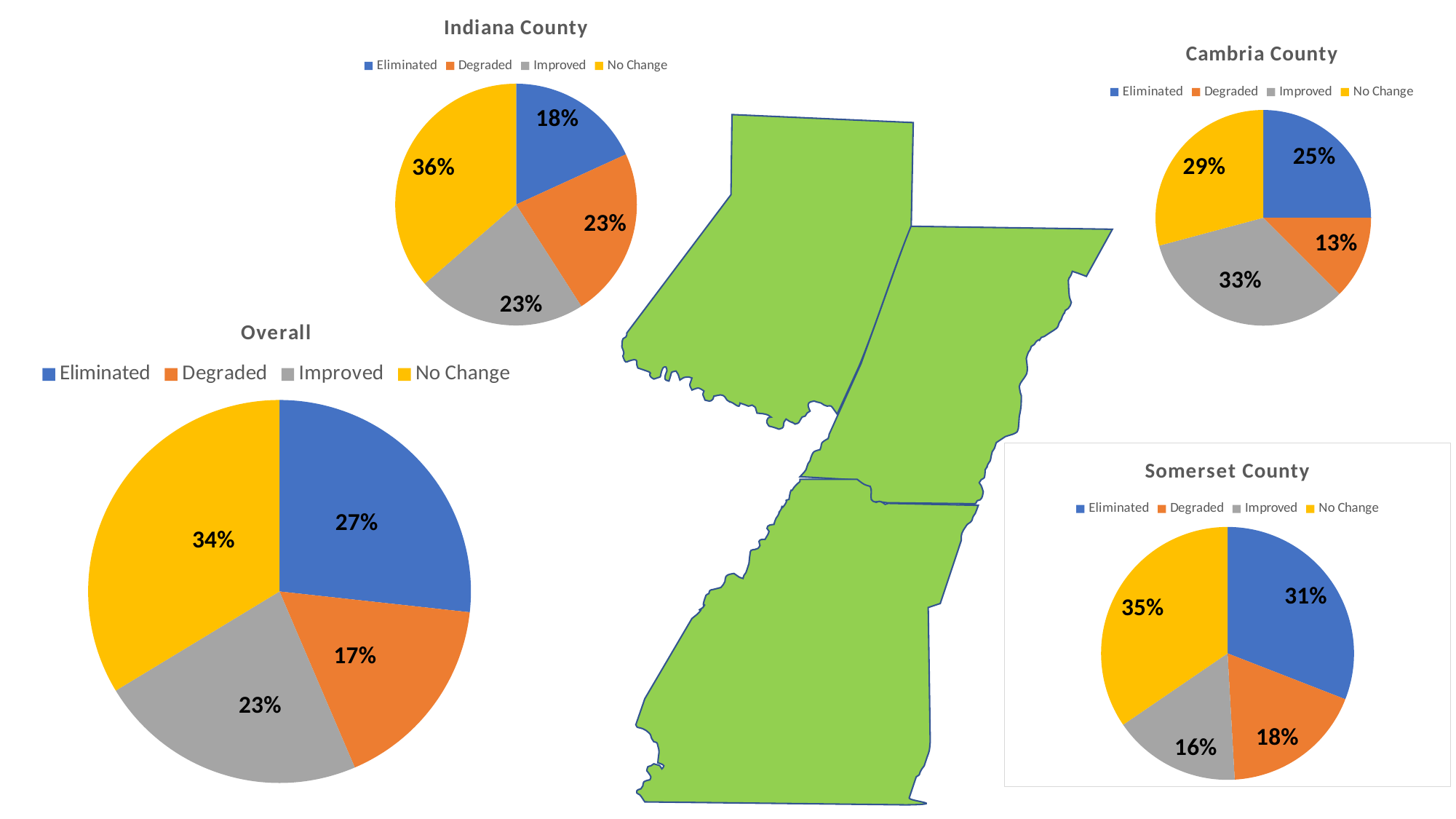
In the Cambria County pie chart, which category has the largest share? Improved What kind of chart is the Cambria County chart? Pie chart How many slices does the Somerset County pie chart have? 4 In the Cambria County pie chart, what percentage is shown for Degraded? 13% In the Indiana County pie chart, which is larger, the Eliminated slice or the Degraded slice? Degraded In the Overall pie chart, which colour represents No Change? Yellow In the Indiana County pie chart, what percentage is shown for No Change? 36% In the Somerset County pie chart, what percentage is shown for Improved? 16% How many entries does the legend of the Overall chart list? 4 In the Overall pie chart, what percentage is labelled for the Eliminated slice? 27% In the Overall pie chart, what is the difference between the No Change share and the Degraded share? 17% In the Somerset County pie chart, which category has the smallest share? Improved